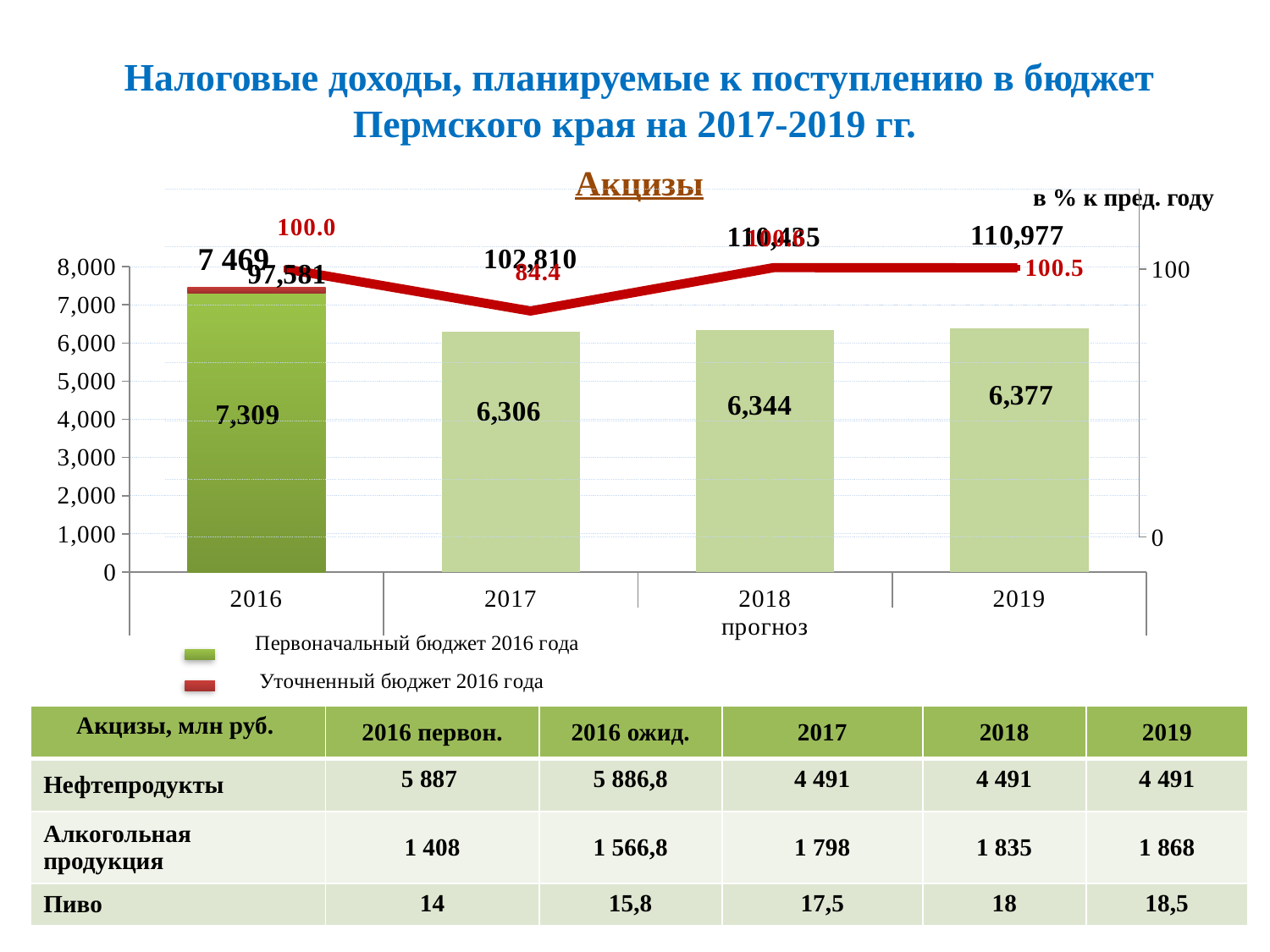
On the Акцизы chart, which year has the highest bar? 2016 On the Акцизы chart, what is the red line value (в % к пред. году) for 2017? 84.4 On the Акцизы chart, is the bar value for 2017 greater or less than 7,000? less On the Акцизы chart, what is the value of the bar for 2017? 6,306 On the Акцизы chart, which year has the lowest bar? 2017 On the Акцизы chart, what is the difference between the bar values for 2016 and 2017? 1,003 How many years are shown on the x axis of the Акцизы chart? 4 On the Акцизы chart, do the bar values rise or fall from 2017 to 2019? rise On the Акцизы chart, what is the value of the bar for 2016? 7,309 On the Акцизы chart, which bar is larger, 2018 or 2019? 2019 On the Акцизы chart, what is the value of the bar for 2019? 6,377 On the Акцизы chart, what is the red line value (в % к пред. году) for 2019? 100.5